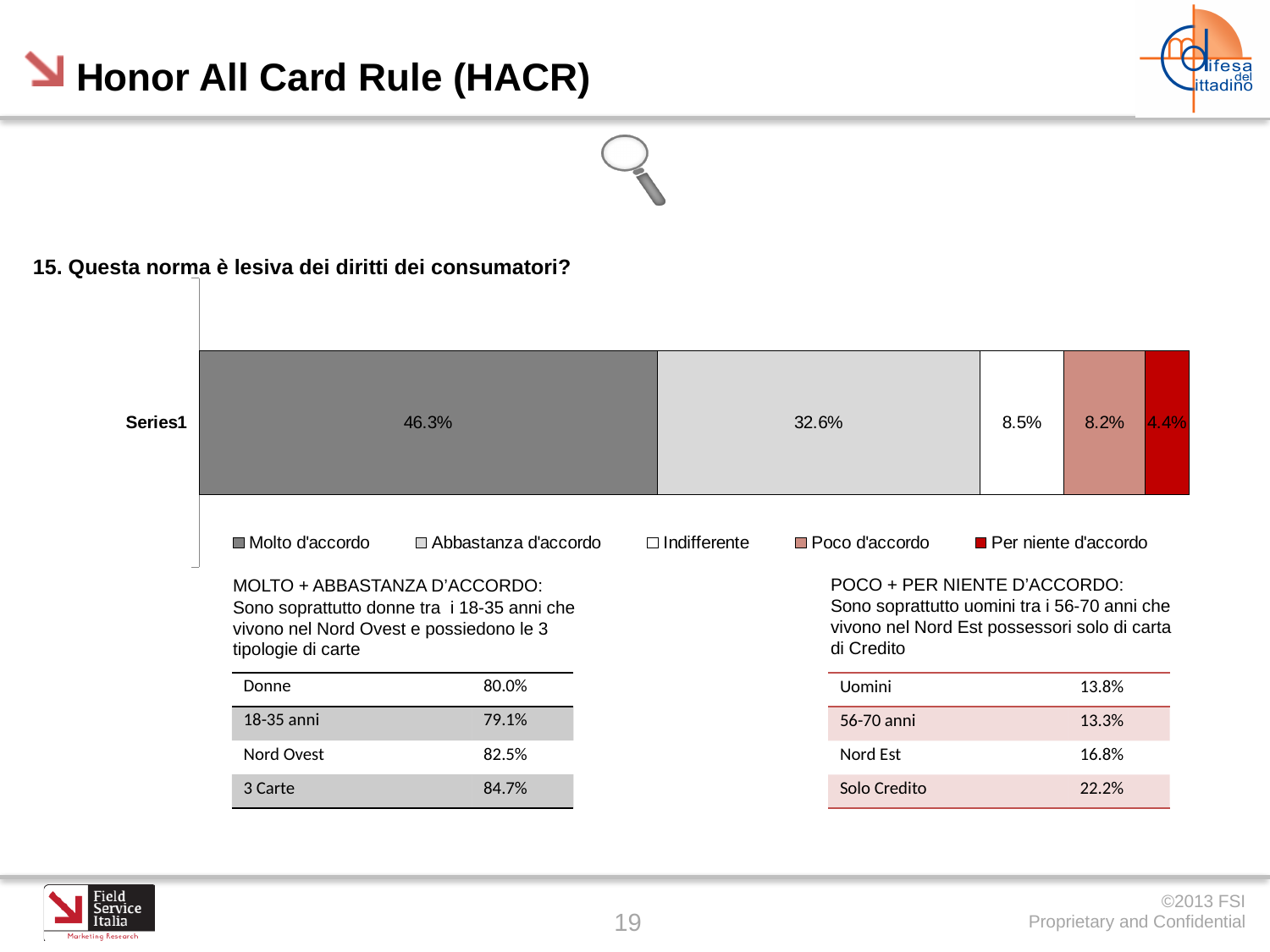
What kind of chart is shown on the slide? Stacked bar chart How many series does the legend list? 5 Which response category has the largest share in the bar? Molto d'accordo What is the value shown for "Per niente d'accordo"? 4.4% What is the combined total of "Poco d'accordo" and "Per niente d'accordo"? 12.6% What is the difference between the "Molto d'accordo" and "Abbastanza d'accordo" values? 13.7% What colour is the "Per niente d'accordo" segment in the bar? Red Which is larger, the value for "Indifferente" or the value for "Poco d'accordo"? Indifferente What is the value shown for "Abbastanza d'accordo"? 32.6% What is the value shown for "Indifferente"? 8.5% Which response category has the smallest share in the bar? Per niente d'accordo What percentage of respondents answered "Molto d'accordo"? 46.3%